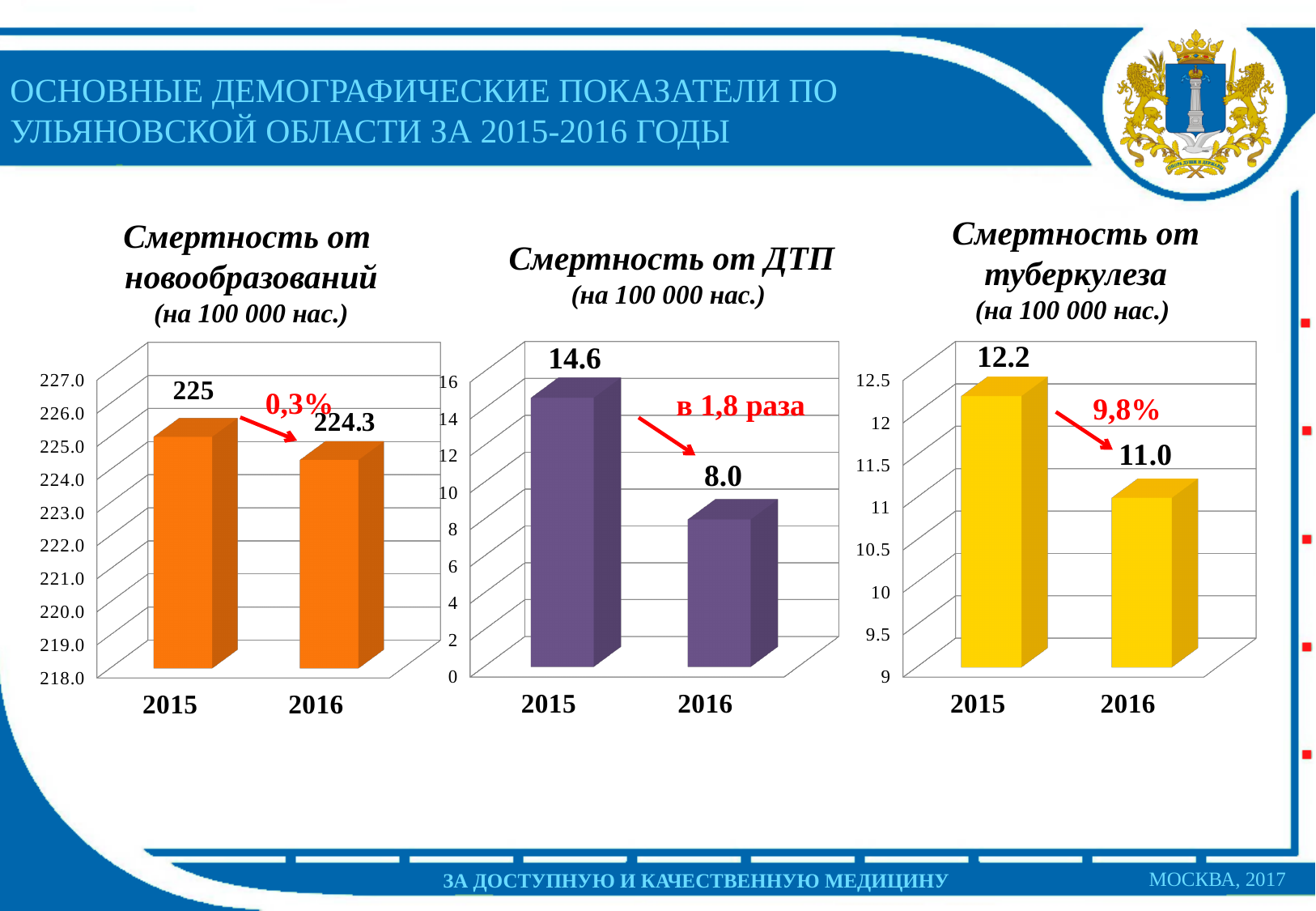
What kind of chart is 'Смертность от ДТП'? bar chart In the chart 'Смертность от ДТП', what is the value for 2015? 14.6 In the chart 'Смертность от ДТП', which year has the lowest value? 2016 In the chart 'Смертность от туберкулеза', what is the difference between the 2015 and 2016 values? 1.2 In the chart 'Смертность от ДТП', what is the value for 2016? 8.0 In the chart 'Смертность от новообразований', do the values rise or fall from 2015 to 2016? fall In the chart 'Смертность от новообразований', what is the value for 2016? 224.3 What percentage change is annotated in red on the chart 'Смертность от туберкулеза'? 9,8% In the chart 'Смертность от туберкулеза', what is the value for 2016? 11.0 In the chart 'Смертность от ДТП', what is the difference between the 2015 and 2016 values? 6.6 In the chart 'Смертность от туберкулеза', which year has the highest value? 2015 In the chart 'Смертность от новообразований', what is the value for 2015? 225